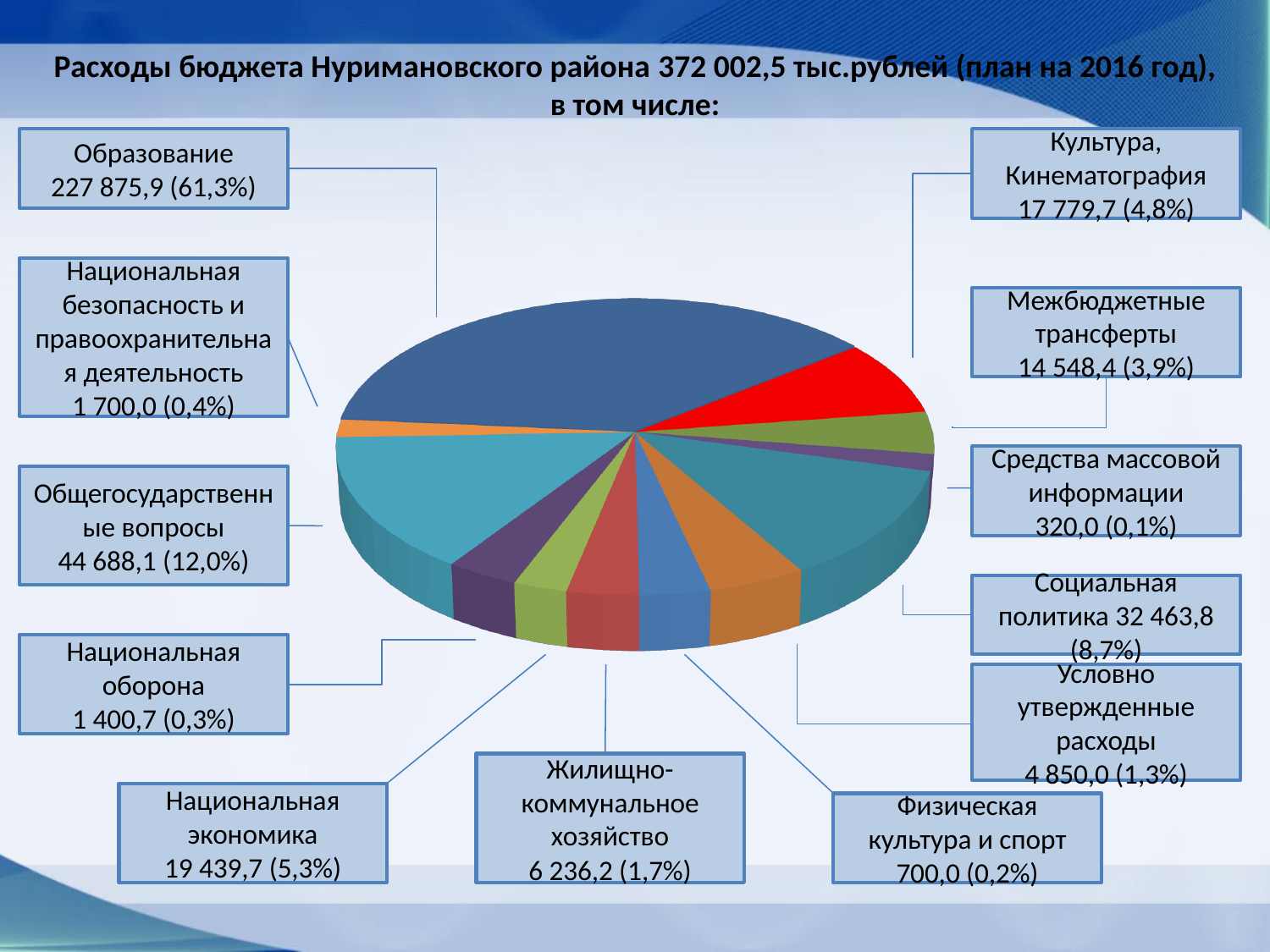
What is the planned expenditure for Образование? 227 875,9 What is the difference between Культура, Кинематография and Межбюджетные трансферты? 3 231,3 Which is larger, Национальная экономика or Культура, Кинематография? Национальная экономика What is the value for Жилищно-коммунальное хозяйство? 6 236,2 Which category has the largest share of the budget? Образование How many expenditure categories are shown in the pie chart? 12 Which category has the smallest share of the budget? Средства массовой информации What share of the budget does Общегосударственные вопросы take? 12,0% What kind of chart is shown on the slide? pie chart What share of the budget goes to Физическая культура и спорт? 0,2% What is the value for Социальная политика? 32 463,8 What is the total budget expenditure stated in the chart title? 372 002,5 тыс.рублей